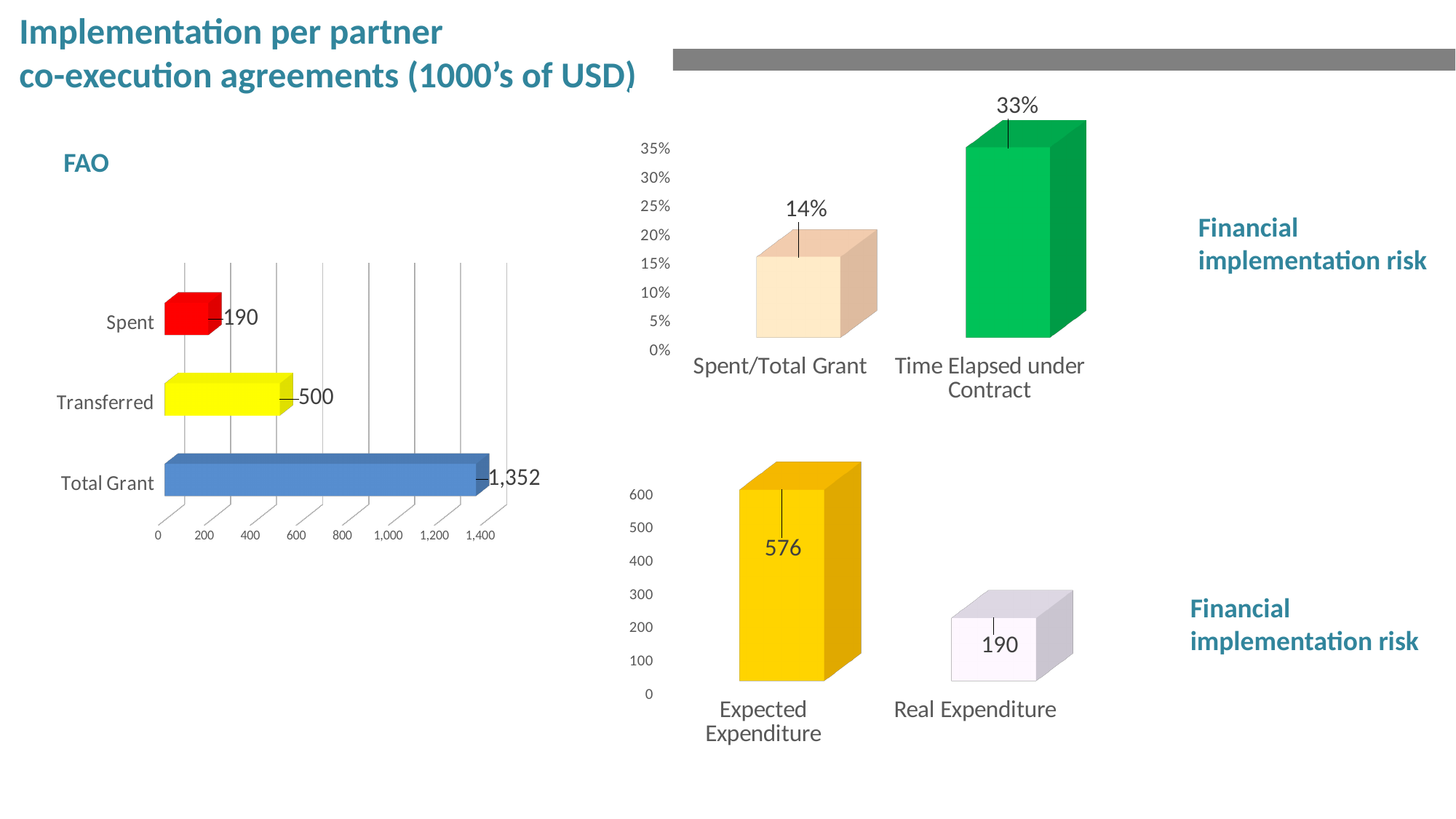
In the FAO chart on the left, how many categories are shown? 3 In the bottom-right chart, what is the difference between Expected Expenditure and Real Expenditure? 386 In the top-right chart, which is larger, Spent/Total Grant or Time Elapsed under Contract? Time Elapsed under Contract In the FAO chart on the left, what colour is the Spent bar? red In the FAO chart on the left, what is the value for Transferred? 500 In the FAO chart on the left, what is the value for Total Grant? 1,352 In the FAO chart on the left, what is the difference between Transferred and Spent? 310 In the FAO chart on the left, which category has the lowest value? Spent What kind of chart is the FAO chart on the left? bar chart In the bottom-right chart, what is the value for Expected Expenditure? 576 In the top-right chart, what is the value for Spent/Total Grant? 14% In the top-right chart, what is the value for Time Elapsed under Contract? 33%